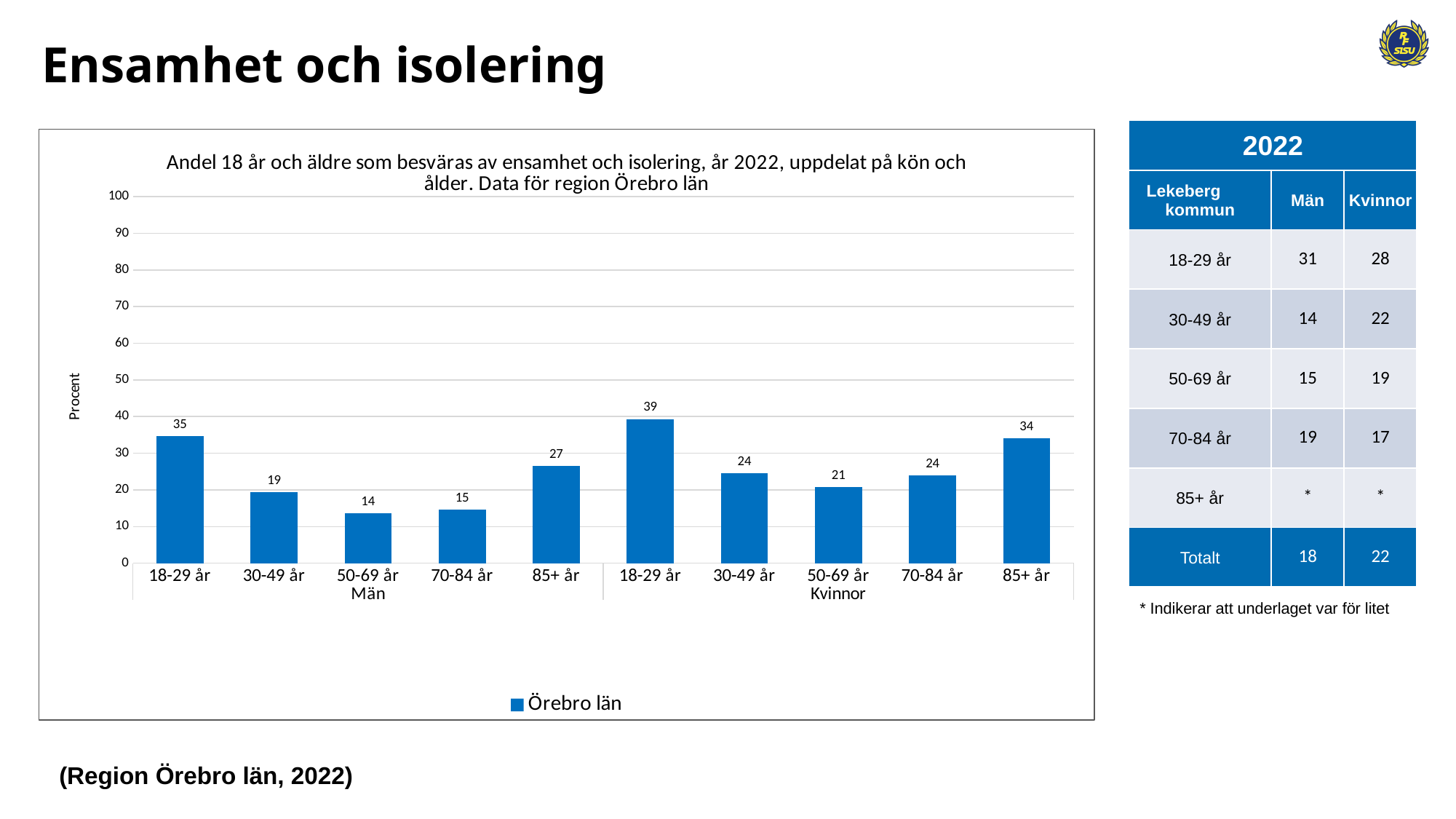
How many bars are plotted in the chart? 10 What is the difference between the 18-29 år values for Kvinnor and Män in the chart? 4 What is the value for 85+ år among Män in the chart? 27 What kind of chart is shown on the slide? bar chart Which is larger in the chart: the 85+ år value for Män or for Kvinnor? Kvinnor What is the value for 50-69 år among Kvinnor in the chart? 21 Which age group among Kvinnor has the highest value in the chart? 18-29 år What is the value for 18-29 år among Män in the chart? 35 Which bar has the lowest value in the chart? 50-69 år (Män) How many series does the chart legend list? 1 What is the legend entry of the chart? Örebro län Is the value for 30-49 år among Kvinnor greater or less than 20 in the chart? greater